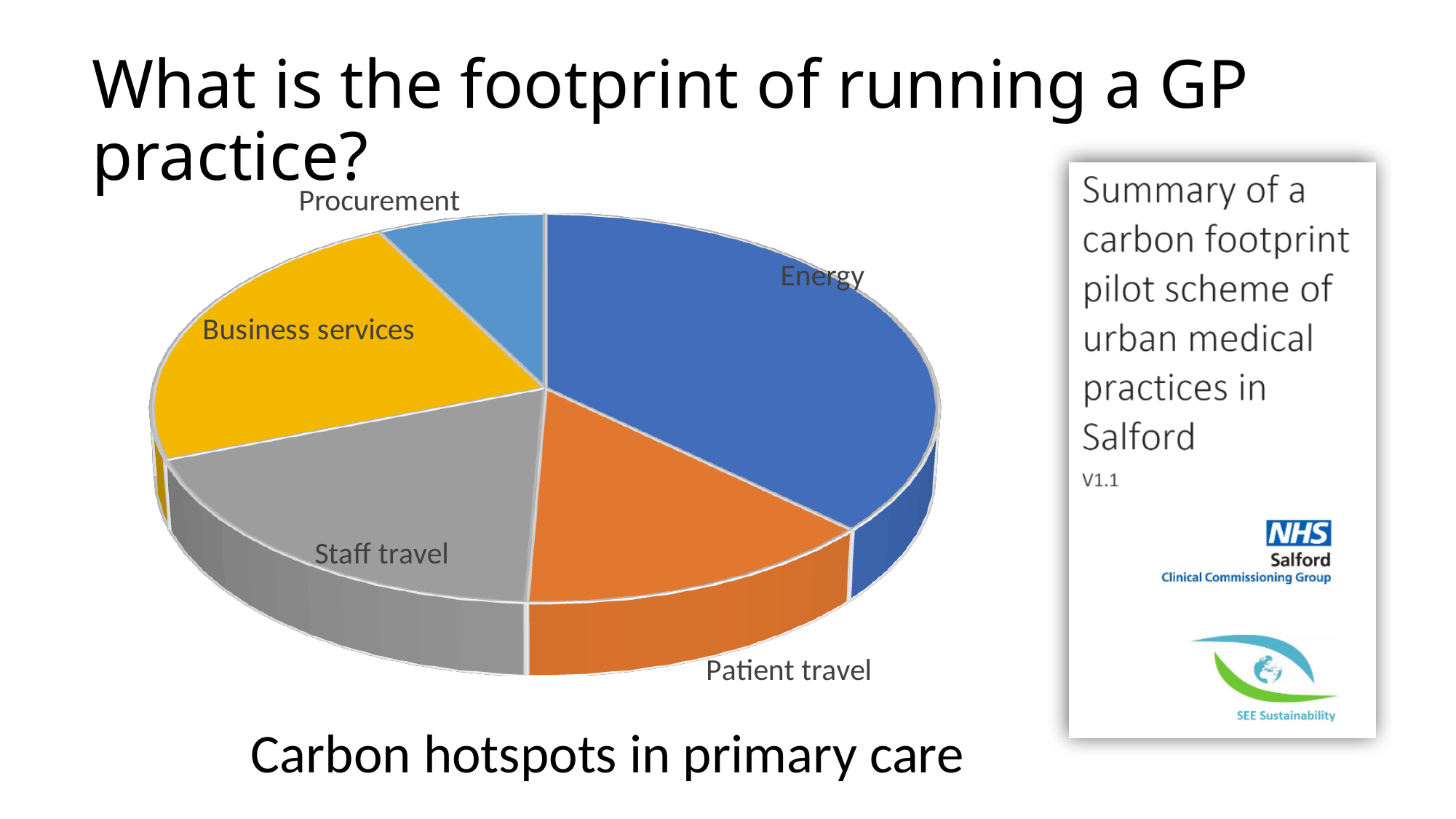
Which slice is larger, Energy or Procurement? Energy What caption appears below the pie chart? Carbon hotspots in primary care What kind of chart is shown on the slide? pie chart Which category has the smallest slice of the pie chart? Procurement Which slice is larger, Business services or Procurement? Business services Which slice is larger, Energy or Staff travel? Energy Which category has the largest slice of the pie chart? Energy How many slices does the pie chart have? 5 What colour is the Staff travel slice of the pie chart? grey